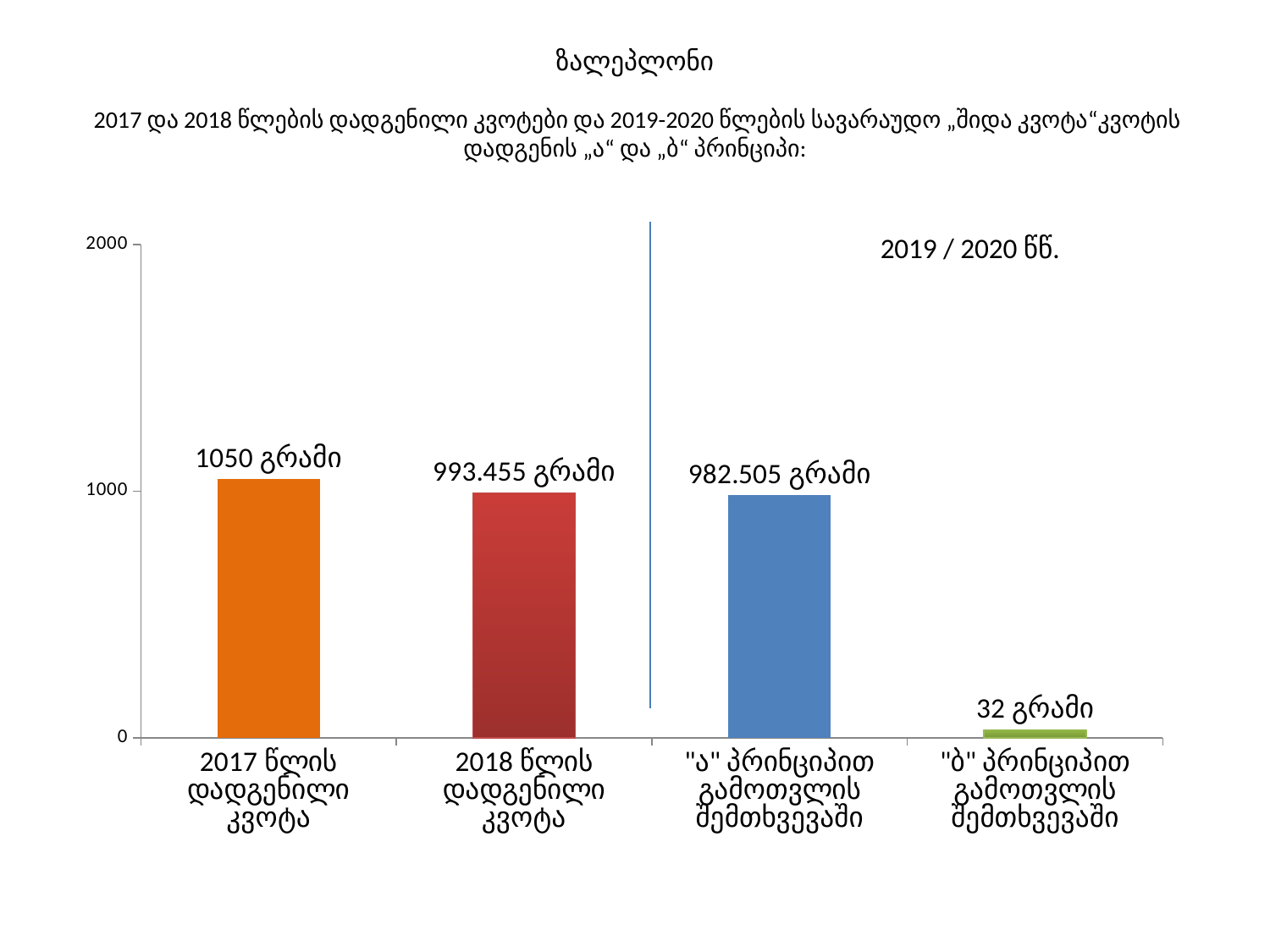
How many bars are plotted in the chart? 4 Which is larger: the value for 2018 წლის დადგენილი კვოტა or the value for "ა" პრინციპით გამოთვლის შემთხვევაში? 2018 წლის დადგენილი კვოტა What value is labelled on the bar for "ა" პრინციპით გამოთვლის შემთხვევაში? 982.505 გრამი What is the difference between the 2017 წლის დადგენილი კვოტა value and the 2018 წლის დადგენილი კვოტა value? 56.545 გრამი What value is labelled on the bar for "ბ" პრინციპით გამოთვლის შემთხვევაში? 32 გრამი Is the value for 2017 წლის დადგენილი კვოტა greater or less than 1000? greater What is the value shown for the 2017 წლის დადგენილი კვოტა bar? 1050 გრამი What kind of chart is shown on the slide? bar chart Which category has the highest value in the chart? 2017 წლის დადგენილი კვოტა Which category has the lowest value in the chart? "ბ" პრინციპით გამოთვლის შემთხვევაში What is the value shown for the 2018 წლის დადგენილი კვოტა bar? 993.455 გრამი What is the title at the top of the slide? ზალეპლონი